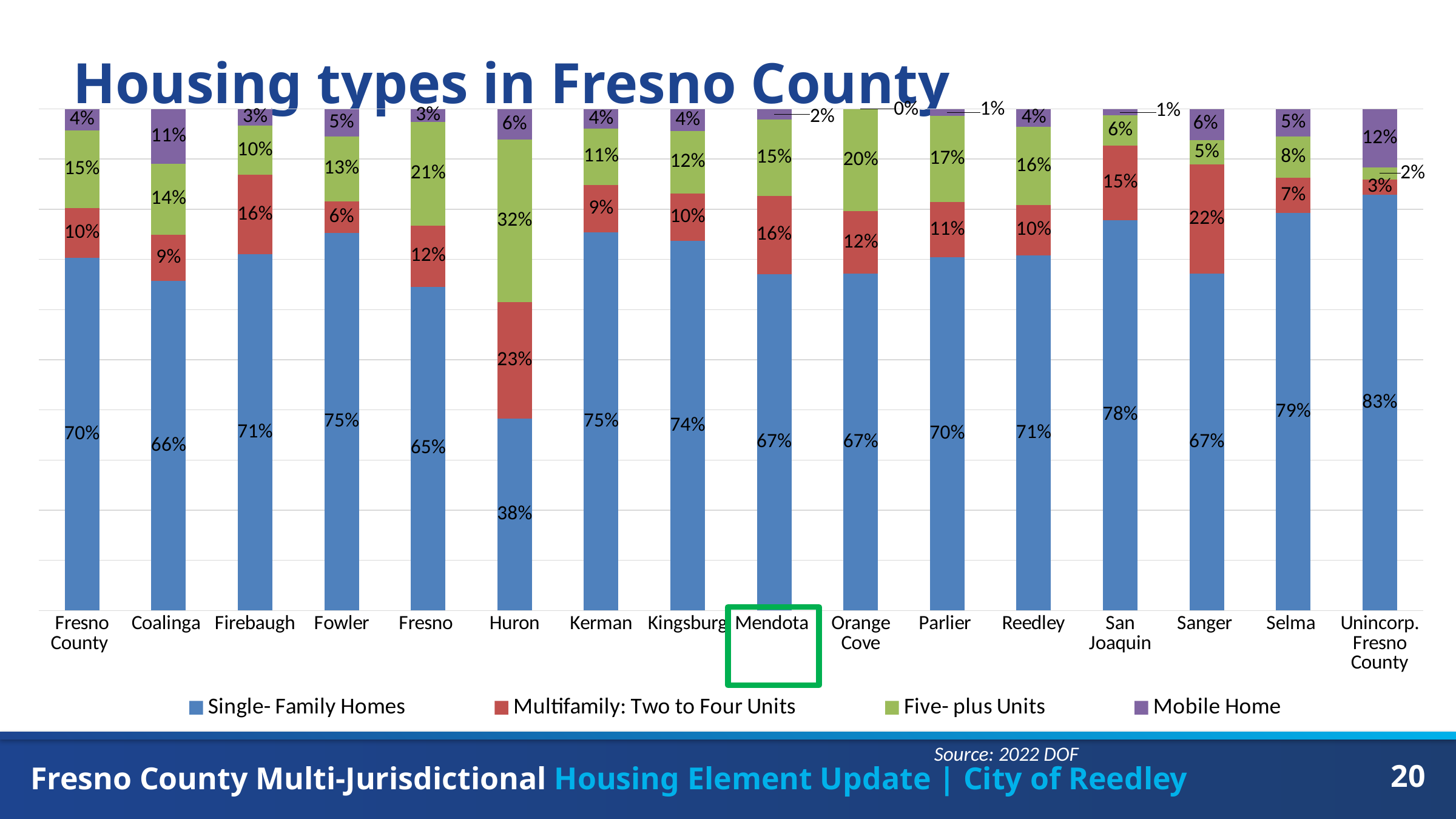
What is the Five-plus Units share for Huron? 32% What percentage of housing in Reedley is Single-Family Homes? 71% What is the difference between the Single-Family Homes share in Selma and in Fresno? 14% How many categories are shown on the x axis? 16 What kind of chart is shown on the slide? Stacked bar chart What is the Multifamily: Two to Four Units share for Sanger? 22% How many series does the legend list? 4 What is the Mobile Home percentage for Coalinga? 11% Which category has the highest Single-Family Homes percentage? Unincorp. Fresno County Which category has the lowest Single-Family Homes percentage? Huron Which has a larger Five-plus Units share, Orange Cove or Parlier? Orange Cove Which category has the highest Multifamily: Two to Four Units percentage? Huron